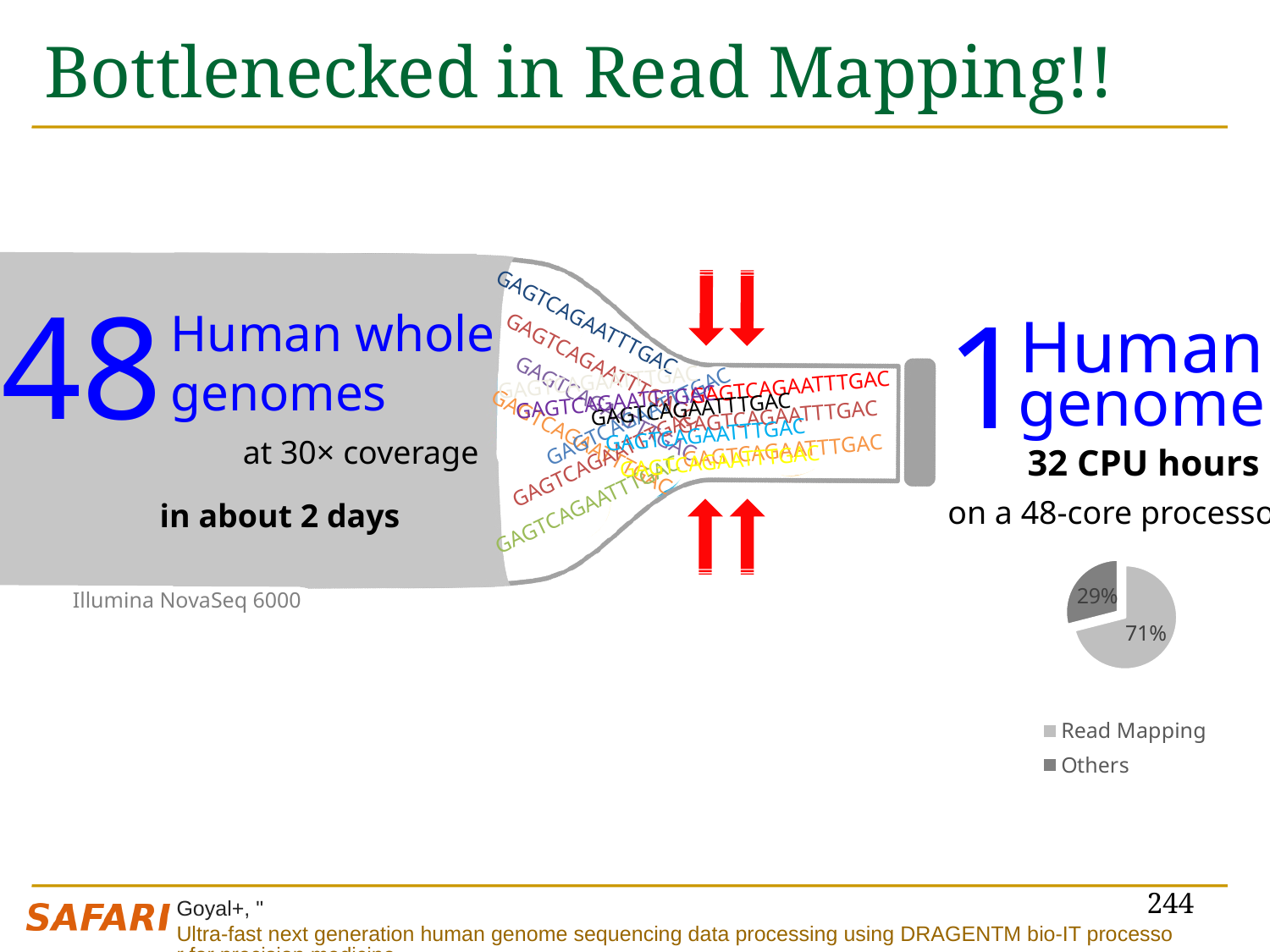
What kind of chart is shown on the slide? pie chart Is the Read Mapping share of the pie chart greater or less than 50%? greater Which legend entry of the pie chart is shown in the darker gray colour? Others Which slice of the pie chart is the smallest? Others Which is larger in the pie chart, Read Mapping or Others? Read Mapping What are the two legend entries of the pie chart? Read Mapping, Others Which slice of the pie chart is the largest? Read Mapping How many entries does the pie chart's legend list? 2 What share of the pie chart does Others take? 29% What is the difference in percentage points between the Read Mapping slice and the Others slice? 42 What share of the pie chart does Read Mapping take? 71% How many slices does the pie chart have? 2